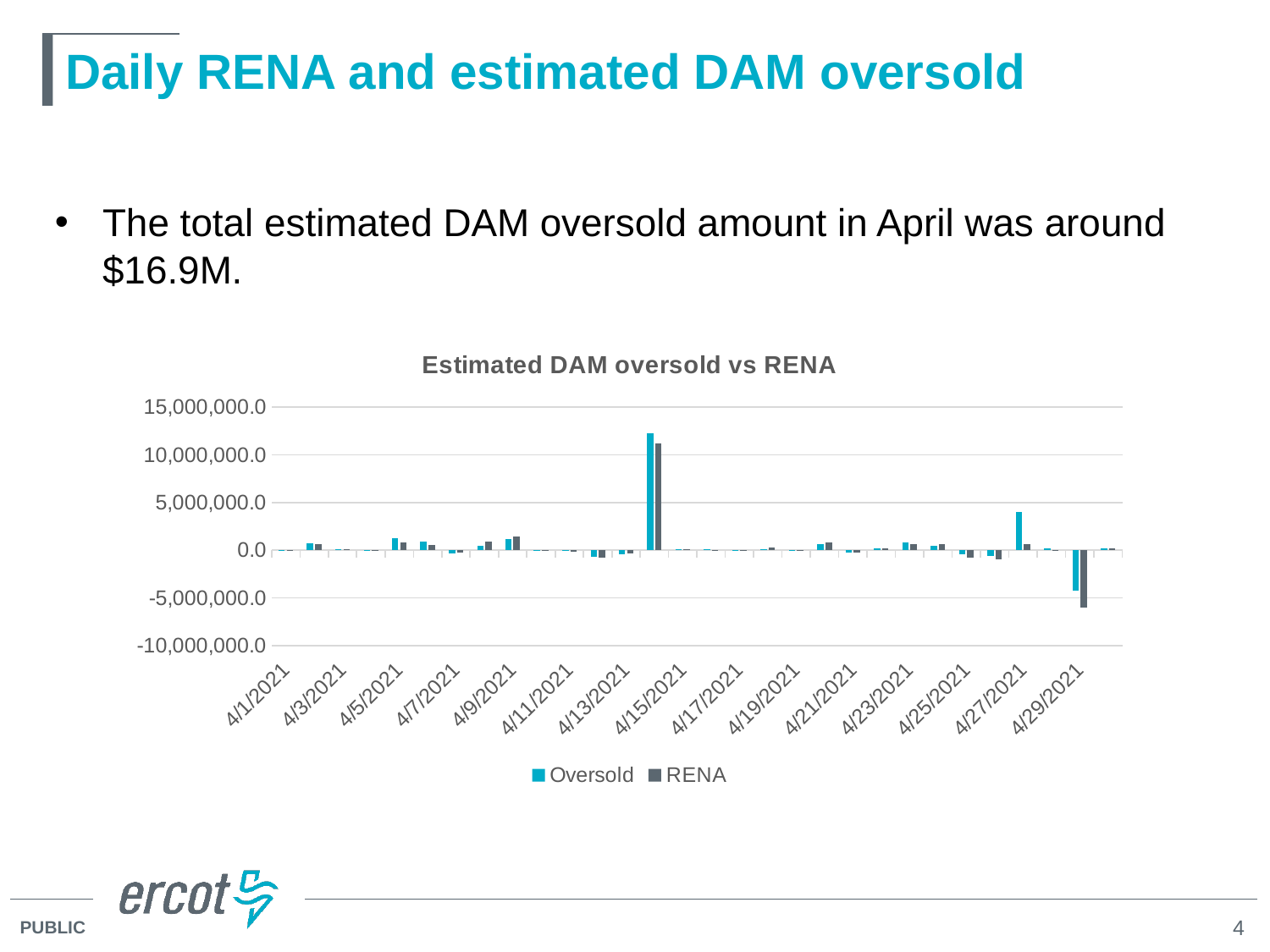
What is the title of the chart? Estimated DAM oversold vs RENA On the day with the most negative bars, which series has the lower value, Oversold or RENA? RENA Is the highest Oversold value in the chart greater or less than 10,000,000.0? greater On the day with the tallest bars, which series has the larger value, Oversold or RENA? Oversold How many date labels are printed along the x axis of the chart? 15 Is the lowest RENA value in the chart greater or less than -5,000,000.0? less What are the two series named in the chart legend? Oversold and RENA What kind of chart is shown on the slide? Bar chart Is the highest RENA value in the chart greater or less than 5,000,000.0? greater How many series does the legend of the chart list? 2